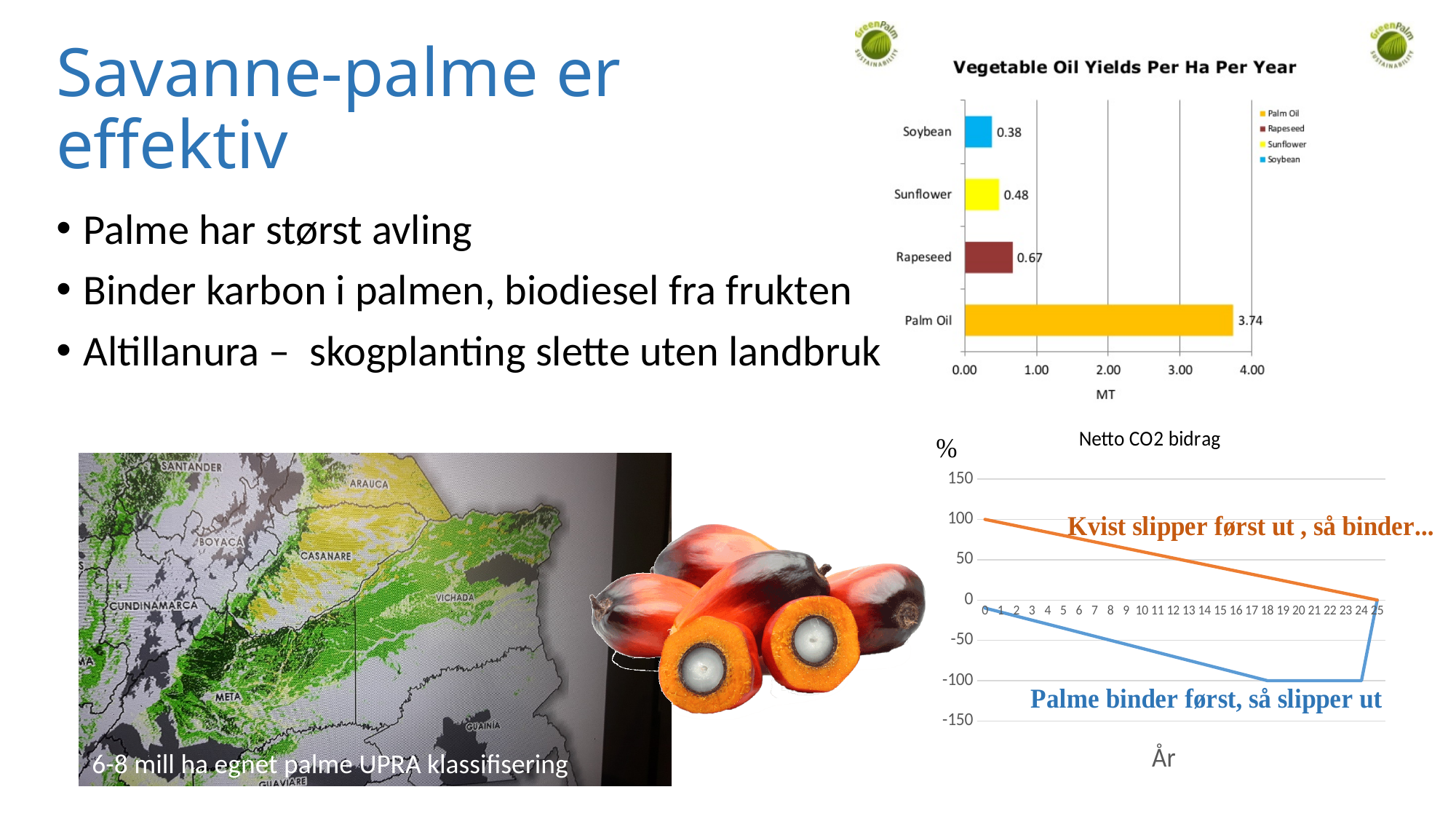
In the 'Vegetable Oil Yields Per Ha Per Year' chart, which category has the highest yield? Palm Oil In the 'Vegetable Oil Yields Per Ha Per Year' chart, what is the value for Rapeseed? 0.67 In the 'Vegetable Oil Yields Per Ha Per Year' chart, which category has the lowest yield? Soybean How many categories are shown in the 'Vegetable Oil Yields Per Ha Per Year' chart? 4 In the 'Vegetable Oil Yields Per Ha Per Year' chart, what is the value for Palm Oil? 3.74 What unit is shown on the x axis of the 'Vegetable Oil Yields Per Ha Per Year' chart? MT In the 'Vegetable Oil Yields Per Ha Per Year' chart, what is the value for Soybean? 0.38 In the 'Vegetable Oil Yields Per Ha Per Year' chart, what is the difference between the Palm Oil and Rapeseed values? 3.07 What kind of chart is 'Netto CO2 bidrag'? Line chart In the 'Netto CO2 bidrag' chart, does the orange line rise or fall from year 0 to year 25? Fall In the 'Vegetable Oil Yields Per Ha Per Year' chart, which is larger, Sunflower or Rapeseed? Rapeseed What kind of chart is 'Vegetable Oil Yields Per Ha Per Year'? Bar chart